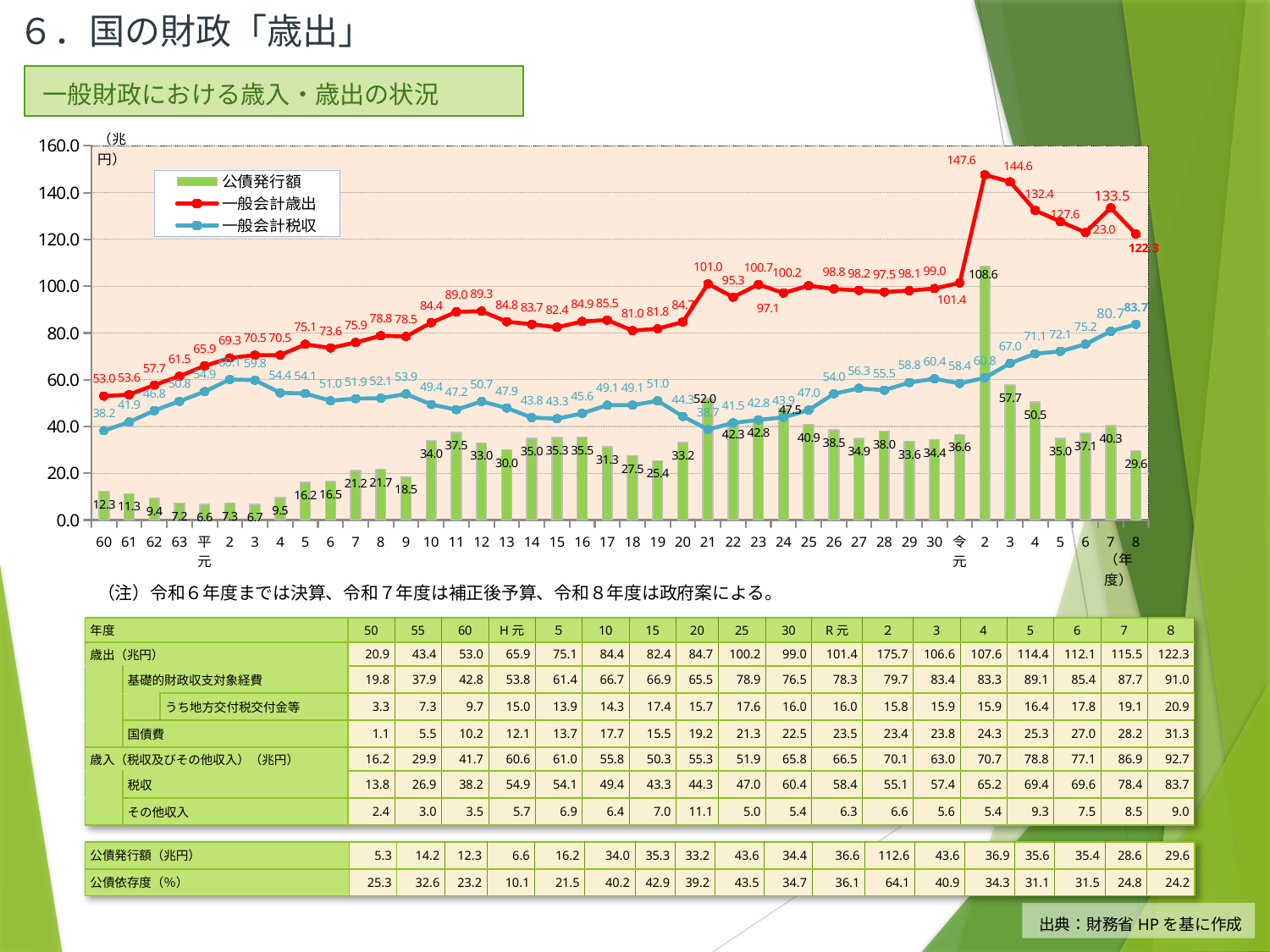
What is the 公債発行額 (bar) value for 令和2年度? 108.6 What is the 一般会計税収 (blue line) value for 令和8年度? 83.7 What is the 公債発行額 value for 令和3年度? 57.7 In which fiscal year is 一般会計歳出 (red line) highest? 令和2年度 (147.6) What is the difference between 一般会計歳出 and 一般会計税収 in 令和8年度? 38.6 What is the 一般会計歳出 value for 平成21年度? 101.0 How many series does the chart legend list? 3 In 平成21年度, which is larger: 公債発行額 or 一般会計税収? 公債発行額 (52.0) In which fiscal year is 公債発行額 (bar) lowest? 平成元年度 (6.6) What kind of chart is shown on the slide? A combined bar and line chart Does 一般会計税収 rise or fall from 令和3年度 to 令和8年度? Rises What colour represents 公債発行額 in the chart legend? Green